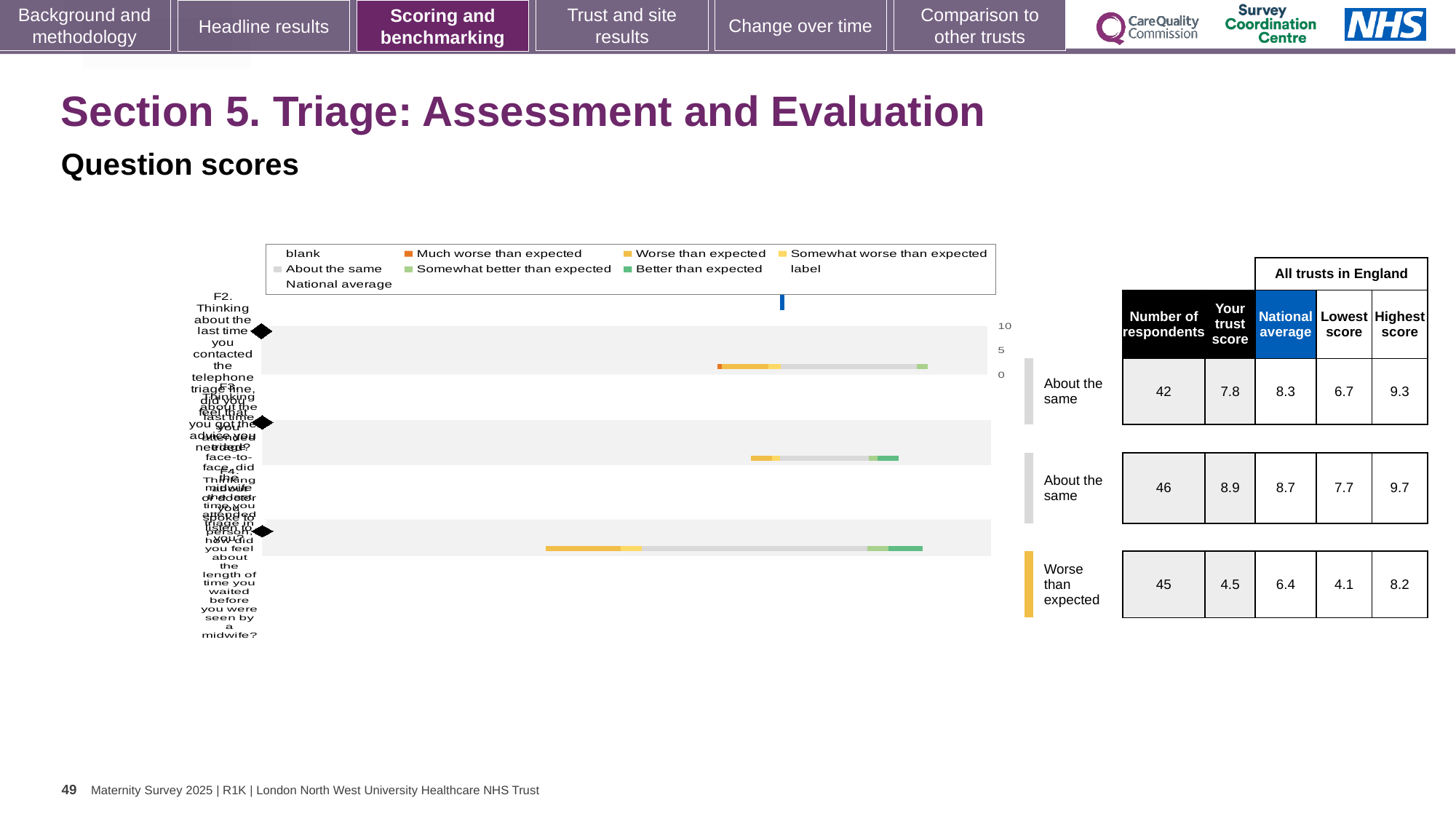
How many question rows are rated 'About the same'? 2 What kind of chart is shown on the slide? bar chart What is the 'Your trust score' for the question rated 'Worse than expected'? 4.5 Which question row has the highest 'Your trust score'? the second row (8.9) What is the 'Your trust score' for the first (top) question row? 7.8 What is the highest score among all trusts in England for the second question row? 9.7 Which question row has the lowest 'Your trust score'? the third row, rated 'Worse than expected' (4.5) For the first question row, which is larger: the trust score or the national average? the national average (8.3) How many question rows are plotted in the chart? 3 What is the difference between the 'Your trust score' of the second row (8.9) and the first row (7.8)? 1.1 How many respondents answered the question rated 'Worse than expected'? 45 What is the national average for the question rated 'Worse than expected'? 6.4